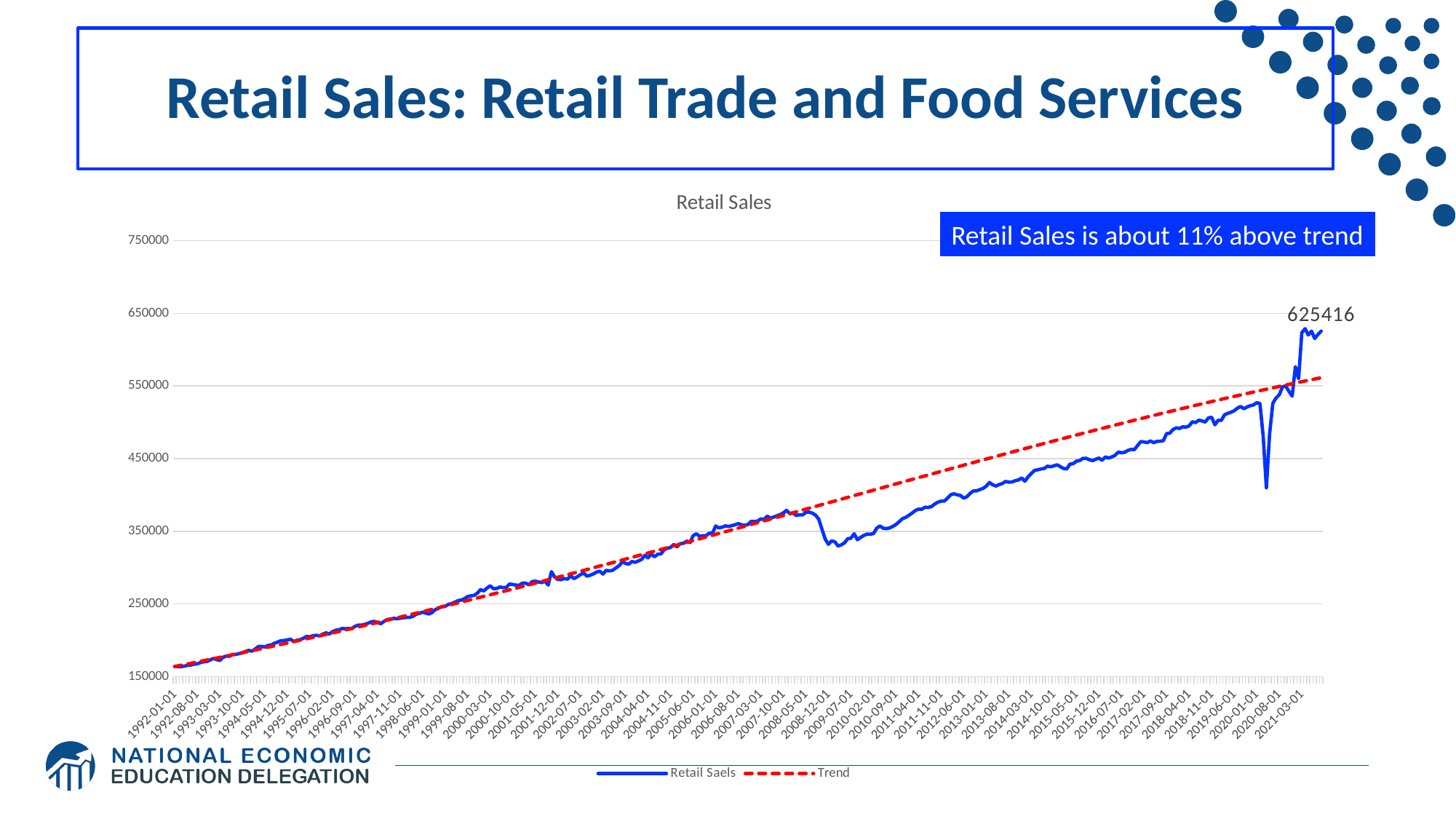
Is the Retail Sales value at 2004-04-01 greater or less than 250000? greater Is the lowest point of the Retail Sales line during the 2020 dip greater or less than 450000? less At the right end of the chart, which line is higher, Retail Sales or Trend? Retail Sales How many series does the chart's legend list? 2 Is the final Retail Sales value greater or less than 550000? greater Does the Retail Sales line generally rise or fall from 1992 to 2021? rise Around 2009-07-01, which line is higher, Retail Sales or Trend? Trend What is the title of the chart? Retail Sales According to the annotation on the chart, how far above trend is Retail Sales? about 11% What is the value printed at the end of the Retail Sales line? 625416 What kind of chart is shown on the slide? line chart